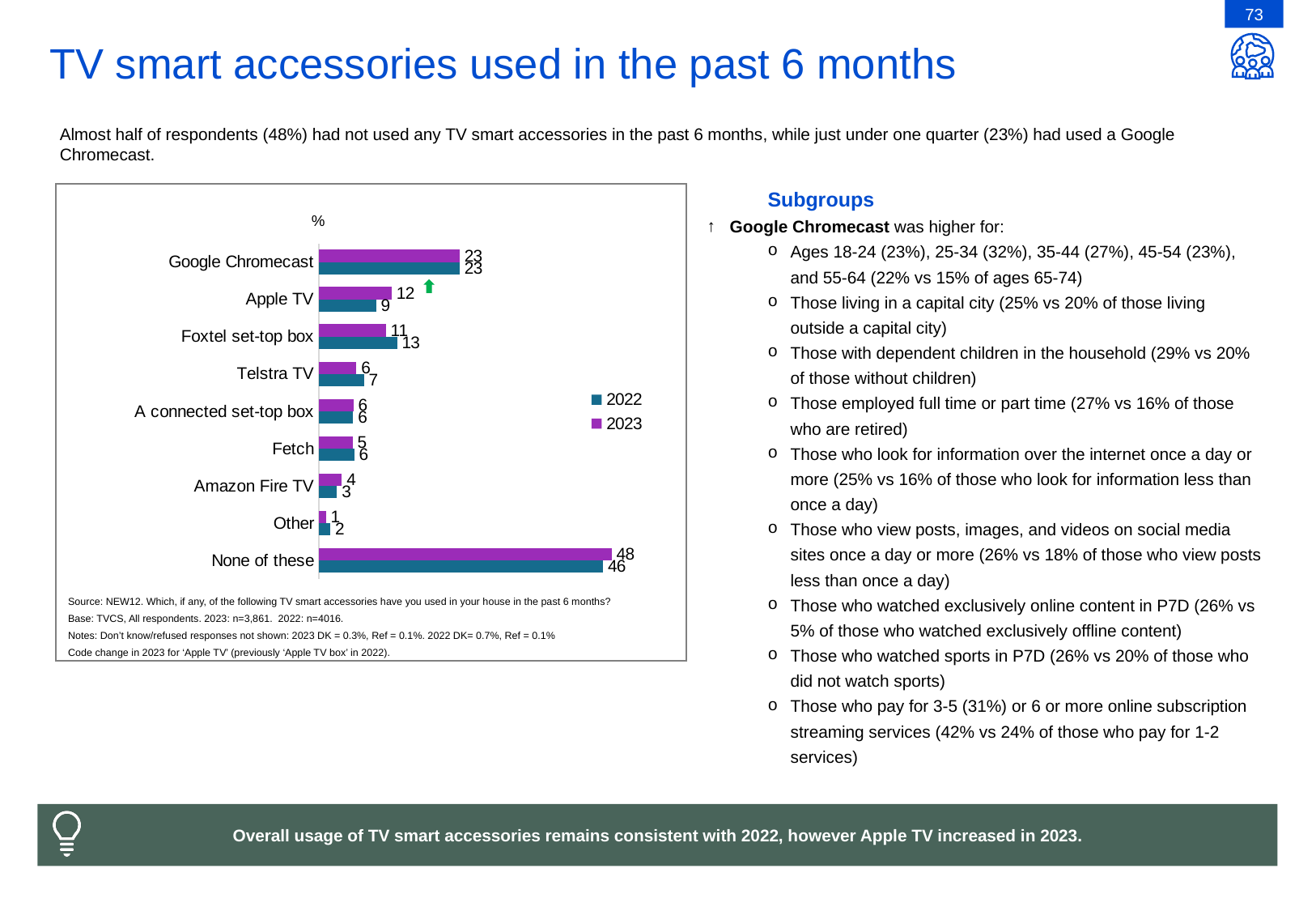
Which category had the highest value in 2023? None of these Which colour represents the 2023 series in the chart? Purple What was the value for None of these in 2023? 48 What was the value for Google Chromecast in 2023? 23 What was the value for Apple TV in 2022? 9 How many categories are shown in the chart? 9 What was the value for Foxtel set-top box in 2022? 13 Which category had the lowest value in 2023? Other Which was larger for Foxtel set-top box, the 2022 value or the 2023 value? 2022 What kind of chart is shown on the slide? Bar chart What is the difference between the 2023 and 2022 values for Apple TV? 3 How many series does the legend list? 2